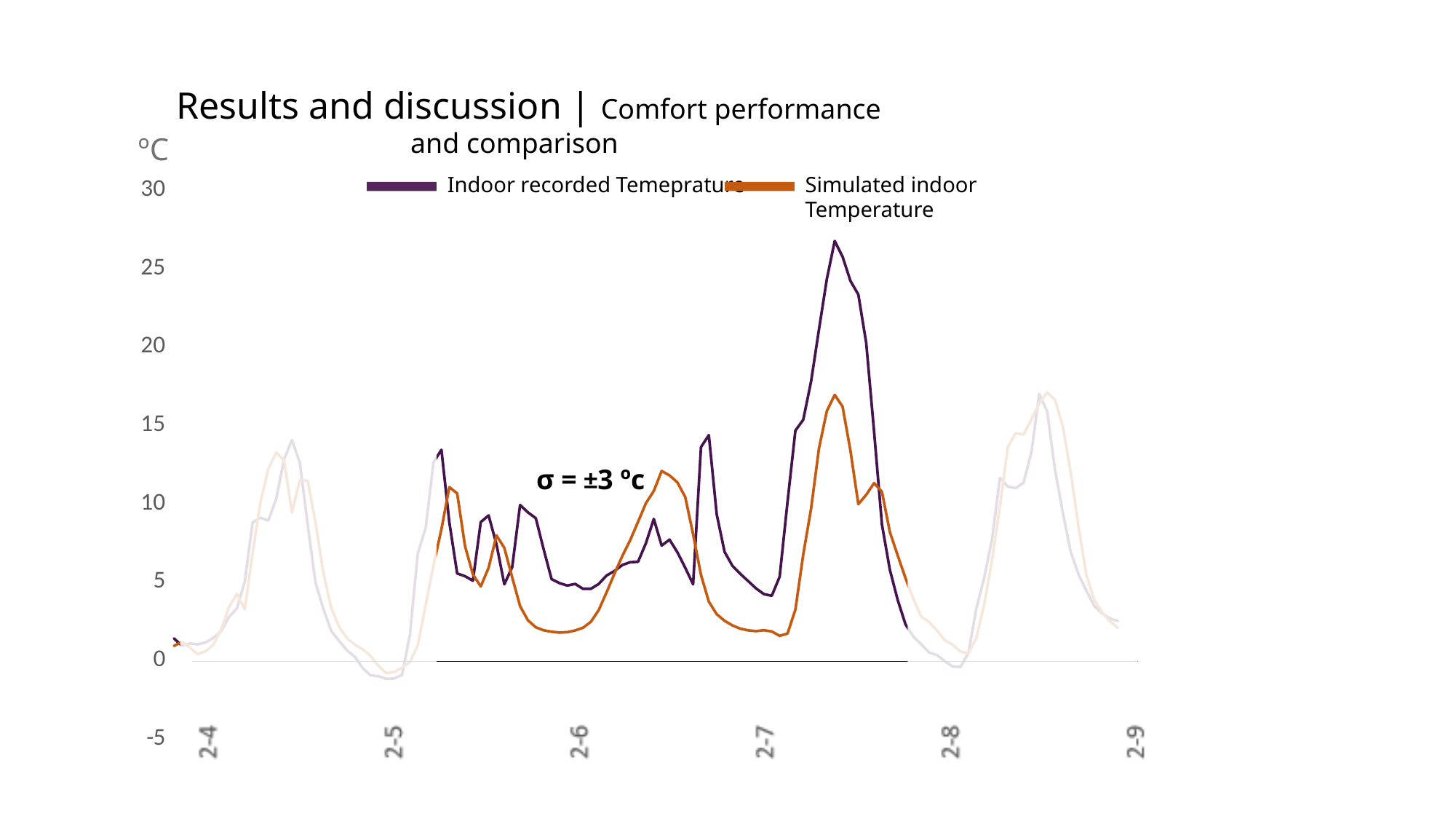
Around 2-6, which series has the higher value, Indoor recorded Temeprature or Simulated indoor Temperature? Indoor recorded Temeprature What are the two series named in the legend? Indoor recorded Temeprature; Simulated indoor Temperature Is the peak value of the Simulated indoor Temperature series between 2-7 and 2-8 greater or less than 15? greater Does the Indoor recorded Temeprature series rise or fall between 2-7 and its peak just after 2-7? rise How many series does the legend list? 2 What standard deviation value is annotated on the chart? σ = ±3 °c Is the peak value of the Indoor recorded Temeprature series between 2-7 and 2-8 greater or less than 25? greater Is the lowest value of the Simulated indoor Temperature series around 2-6 greater or less than 5? less Which series reaches the higher peak between 2-7 and 2-8, Indoor recorded Temeprature or Simulated indoor Temperature? Indoor recorded Temeprature How many date labels are shown on the x axis? 6 What kind of chart is shown on the slide? line chart